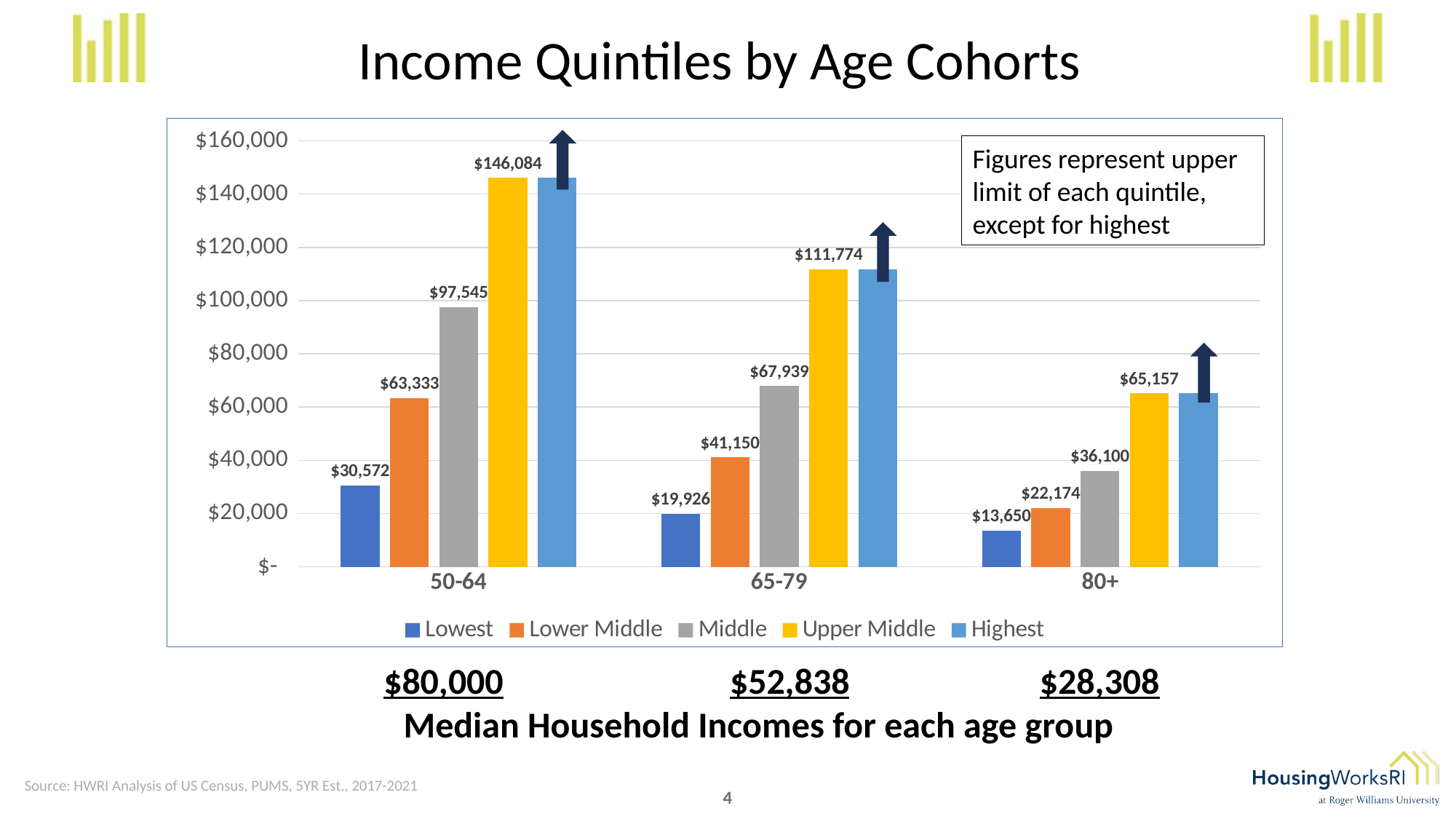
Do the Upper Middle values rise or fall from the 50-64 group to the 80+ group? fall How many series does the legend list? 5 Which age group has the lowest value for the Middle quintile? 80+ What is the value for the Lowest quintile in the 50-64 age group? $30,572 What is the value for the Upper Middle quintile in the 80+ age group? $65,157 What is the difference between the Lower Middle values for the 50-64 and 65-79 age groups? $22,183 Which is larger: the Middle value for 50-64 or the Upper Middle value for 65-79? Upper Middle value for 65-79 Which age group has the highest value for the Lowest quintile? 50-64 What is the value for the Lower Middle quintile in the 80+ age group? $22,174 Is the Highest bar for the 80+ age group greater or less than $60,000? greater How many age groups are shown on the x axis? 3 What is the value for the Middle quintile in the 65-79 age group? $67,939